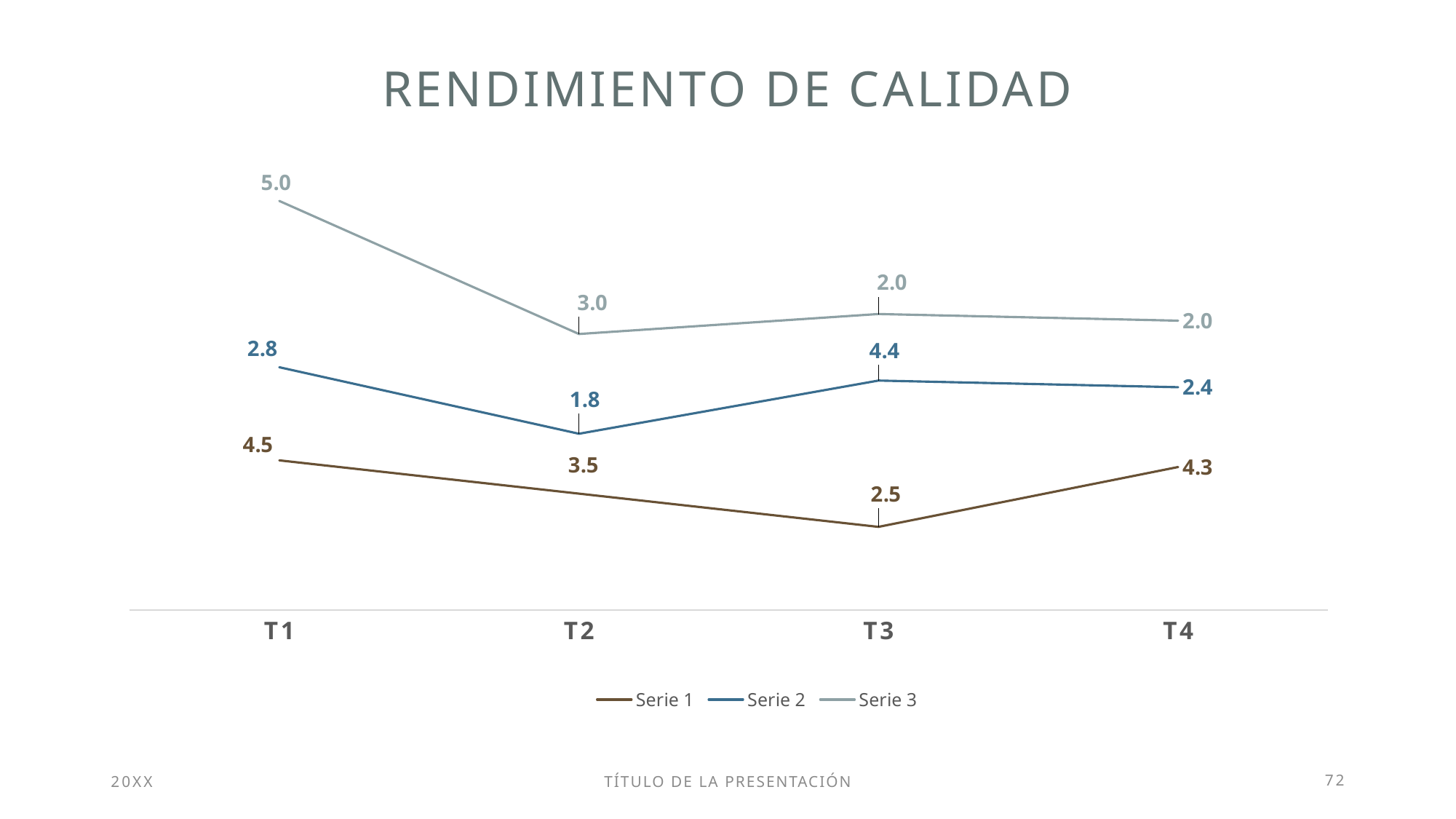
How many series does the legend list? 3 What is the title of the chart? RENDIMIENTO DE CALIDAD At which quarter does Serie 1 have its lowest value? T3 What is the value of Serie 2 at T4? 2.4 What is the value of Serie 3 at T1? 5.0 What kind of chart is shown on the slide? Line chart Which is larger at T2: the value of Serie 1 or the value of Serie 2? Serie 1 At which quarter does Serie 2 reach its highest value? T3 What is the difference between the Serie 3 values at T1 and T2? 2.0 What is the value of Serie 1 at T3? 2.5 How many quarters are shown on the x axis? 4 What is the difference between the Serie 1 values at T1 and T4? 0.2